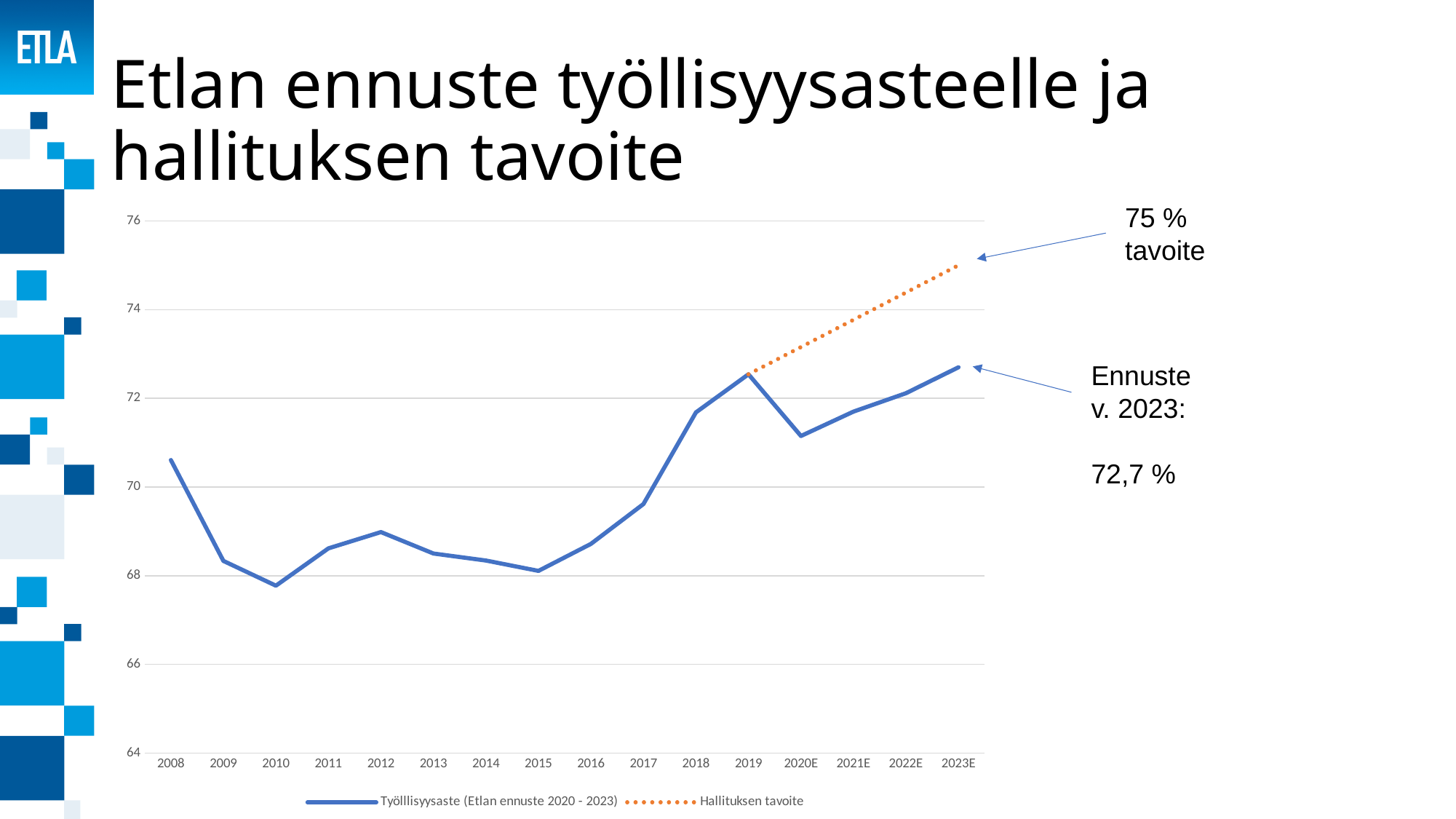
In which year is the employment rate (Työllisyysaste) lowest? 2010 Is the employment rate for 2012 greater or less than 70? less What is the government's target (Hallituksen tavoite) value shown on the chart? 75 % What is the forecast employment rate (Työllisyysaste) for 2023E according to the annotation? 72,7 % What kind of chart is shown on the slide? line chart How many series does the legend list? 2 Does the employment rate rise or fall from 2015 to 2019? rise Which year has a higher employment rate, 2008 or 2009? 2008 Is the employment rate for 2010 greater or less than 68? less Is the employment rate for 2018 greater or less than 70? greater Which year has a higher employment rate, 2019 or 2020E? 2019 How many years are shown on the x axis? 16